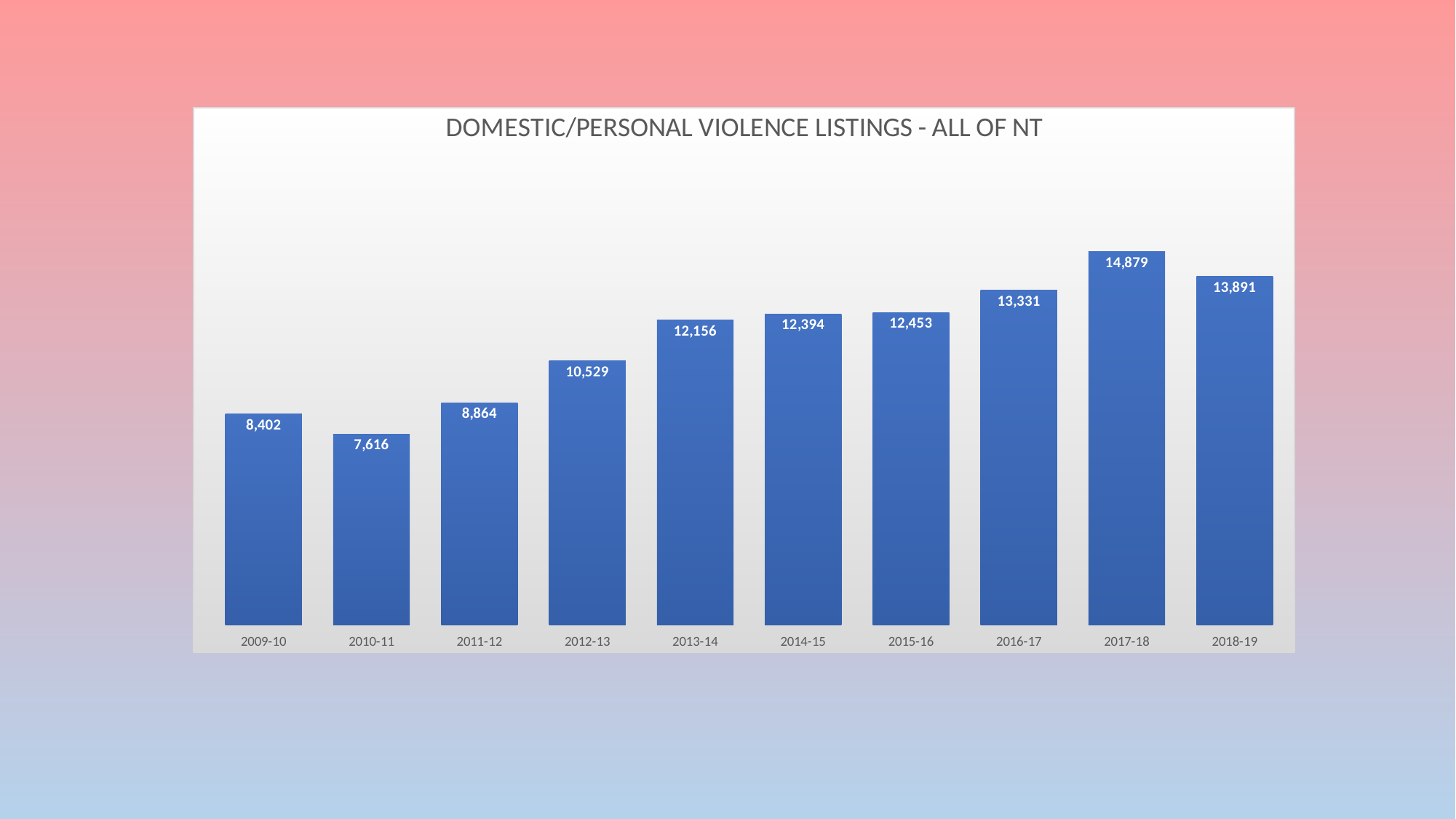
What is the difference between the values for 2009-10 and 2010-11? 786 What is the value for 2013-14? 12,156 What is the value for 2018-19? 13,891 Which is larger, the value for 2012-13 or the value for 2011-12? 2012-13 How many years are shown on the x axis? 10 Which year has the lowest number of listings? 2010-11 What is the title of the chart? DOMESTIC/PERSONAL VIOLENCE LISTINGS - ALL OF NT What is the value for 2009-10? 8,402 Which year has the highest number of listings? 2017-18 What is the difference between the values for 2017-18 and 2018-19? 988 Do the values generally rise or fall from 2010-11 to 2017-18? Rise What kind of chart is this? Bar chart